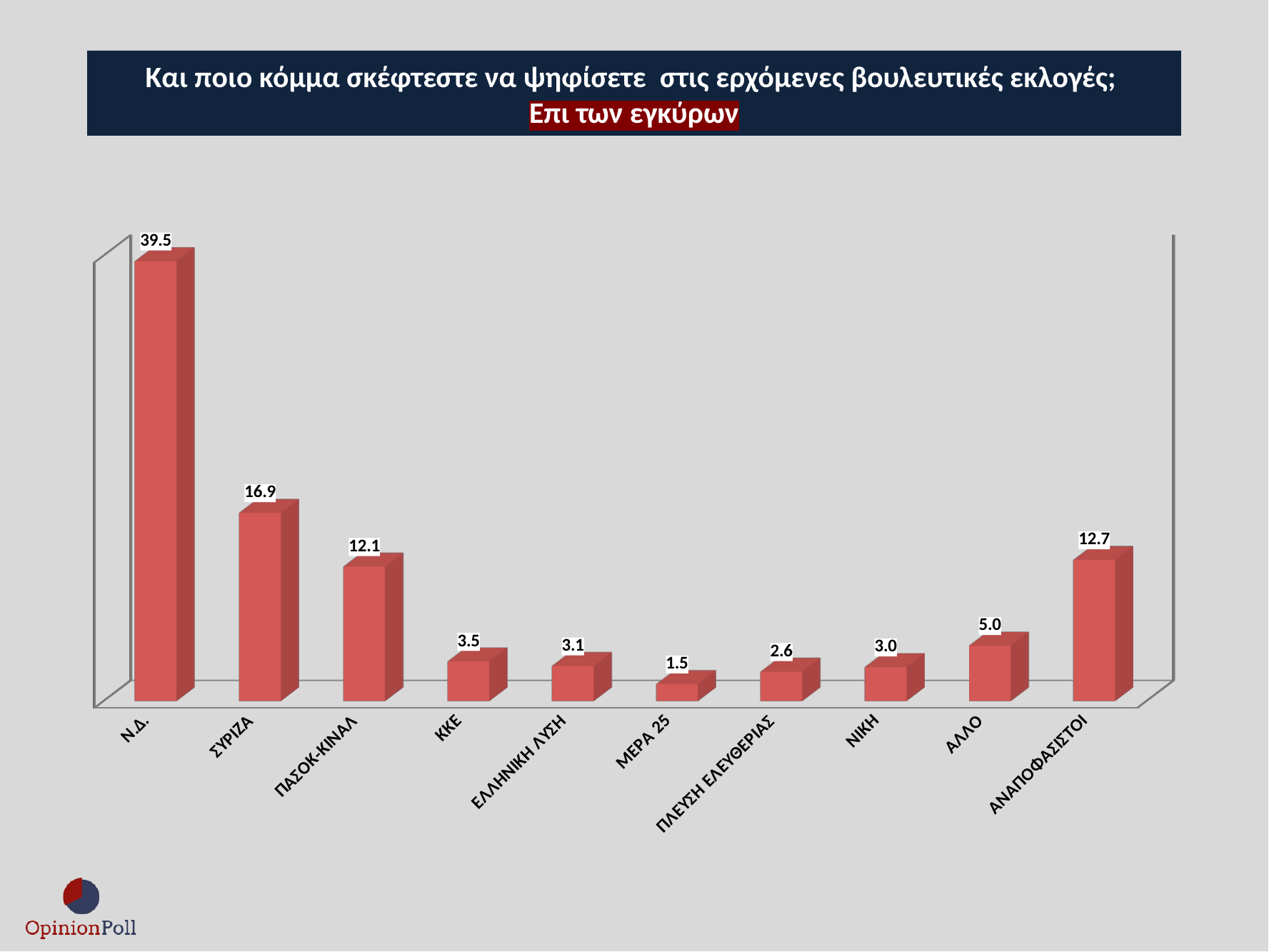
Which category has the lowest value? ΜΕΡΑ 25 What is the difference between the values for ΑΝΑΠΟΦΑΣΙΣΤΟΙ and ΠΑΣΟΚ-ΚΙΝΑΛ? 0.6 What is the value for ΑΝΑΠΟΦΑΣΙΣΤΟΙ? 12.7 What is the value for ΠΛΕΥΣΗ ΕΛΕΥΘΕΡΙΑΣ? 2.6 What is the value for Ν.Δ.? 39.5 How many categories are shown on the x axis? 10 What is the value for ΣΥΡΙΖΑ? 16.9 Which is larger, the value for ΚΚΕ or the value for ΑΛΛΟ? ΑΛΛΟ What is the subtitle shown in the red highlight under the chart title? Επι των εγκύρων What is the difference between the values for Ν.Δ. and ΣΥΡΙΖΑ? 22.6 What kind of chart is shown on the slide? Bar chart Which category has the highest value? Ν.Δ.